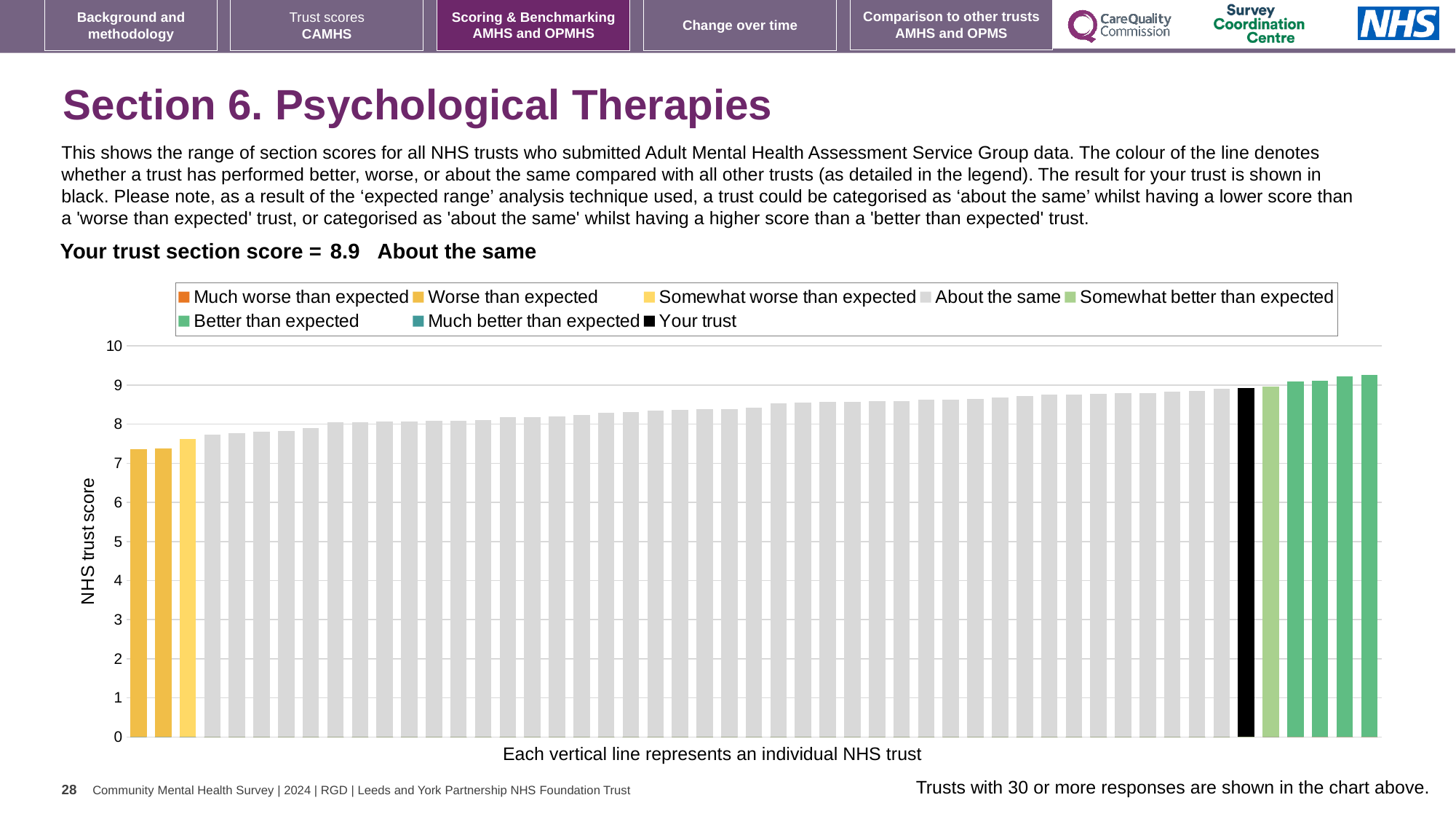
How many yellow (worse than expected / somewhat worse than expected) bars are shown in the chart? 3 Is the value of the black 'Your trust' bar greater or less than 8? greater How many green bars are shown to the right of the black 'Your trust' bar? 5 Is the value of the leftmost bar greater or less than 8? less How many entries does the chart legend list? 8 Which is larger, the black 'Your trust' bar or the leftmost yellow bar? The black 'Your trust' bar What colour is the bar representing your trust in the chart? Black What is the label on the vertical axis of the chart? NHS trust score What kind of chart is shown on the slide? Bar chart What is the section score for your trust shown on the slide? 8.9 Is the value of the rightmost bar greater or less than 9? greater Do the bar values rise or fall from left to right along the x axis? rise